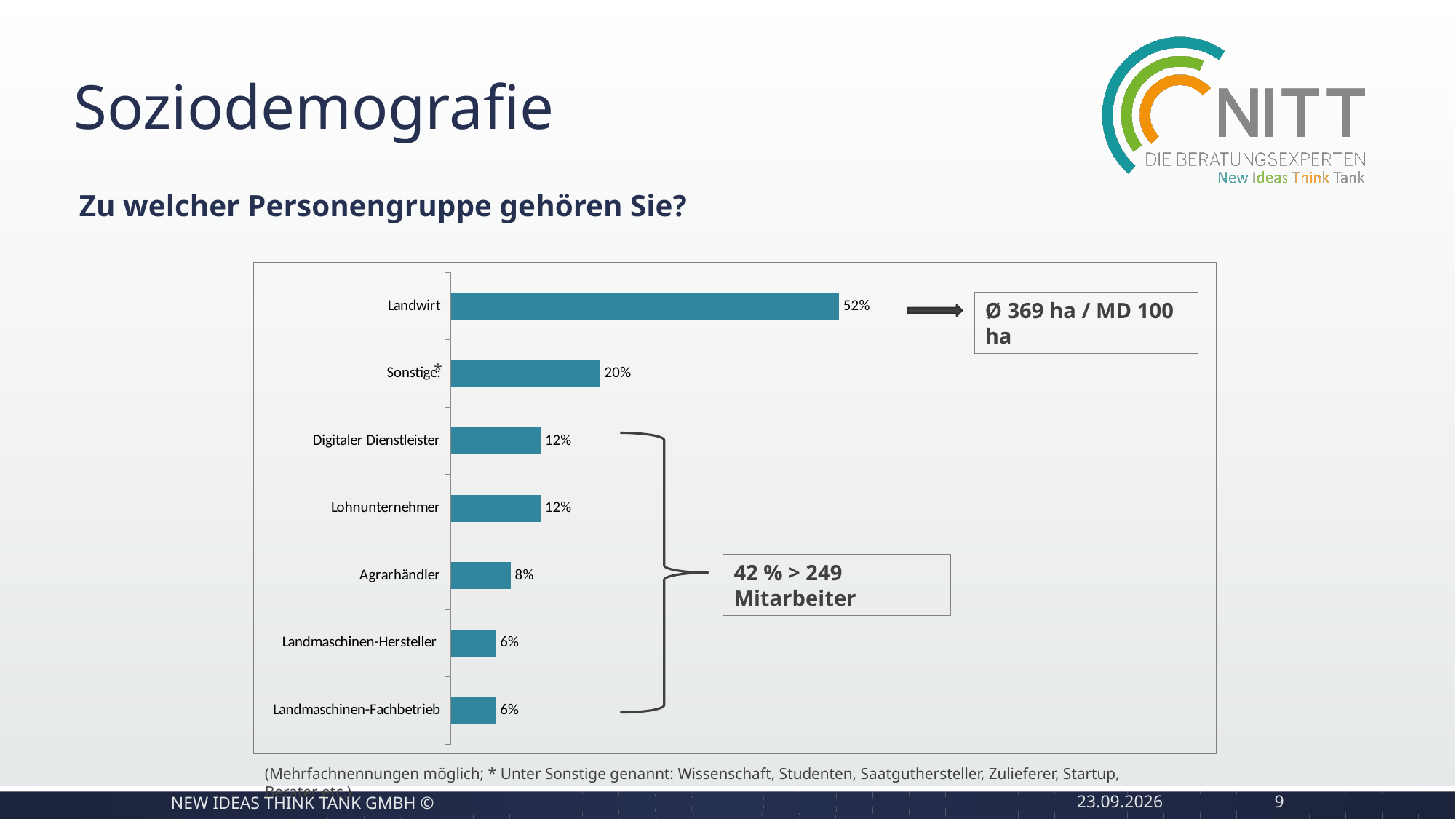
What percentage is shown for Sonstige? 20% What is the value shown for Agrarhändler? 8% Which is larger, Lohnunternehmer or Landmaschinen-Hersteller? Lohnunternehmer How many categories are shown in the chart? 7 What is the difference between the Landwirt and Sonstige values? 32% What percentage of respondents are Landwirt? 52% What type of chart is shown on the slide? Bar chart What is the difference between Digitaler Dienstleister and Agrarhändler? 4% Which two categories both have a value of 12%? Digitaler Dienstleister and Lohnunternehmer What does the annotation box next to the Landwirt bar say? Ø 369 ha / MD 100 ha Which category has the highest value? Landwirt What question does the chart answer, according to the subtitle? Zu welcher Personengruppe gehören Sie?